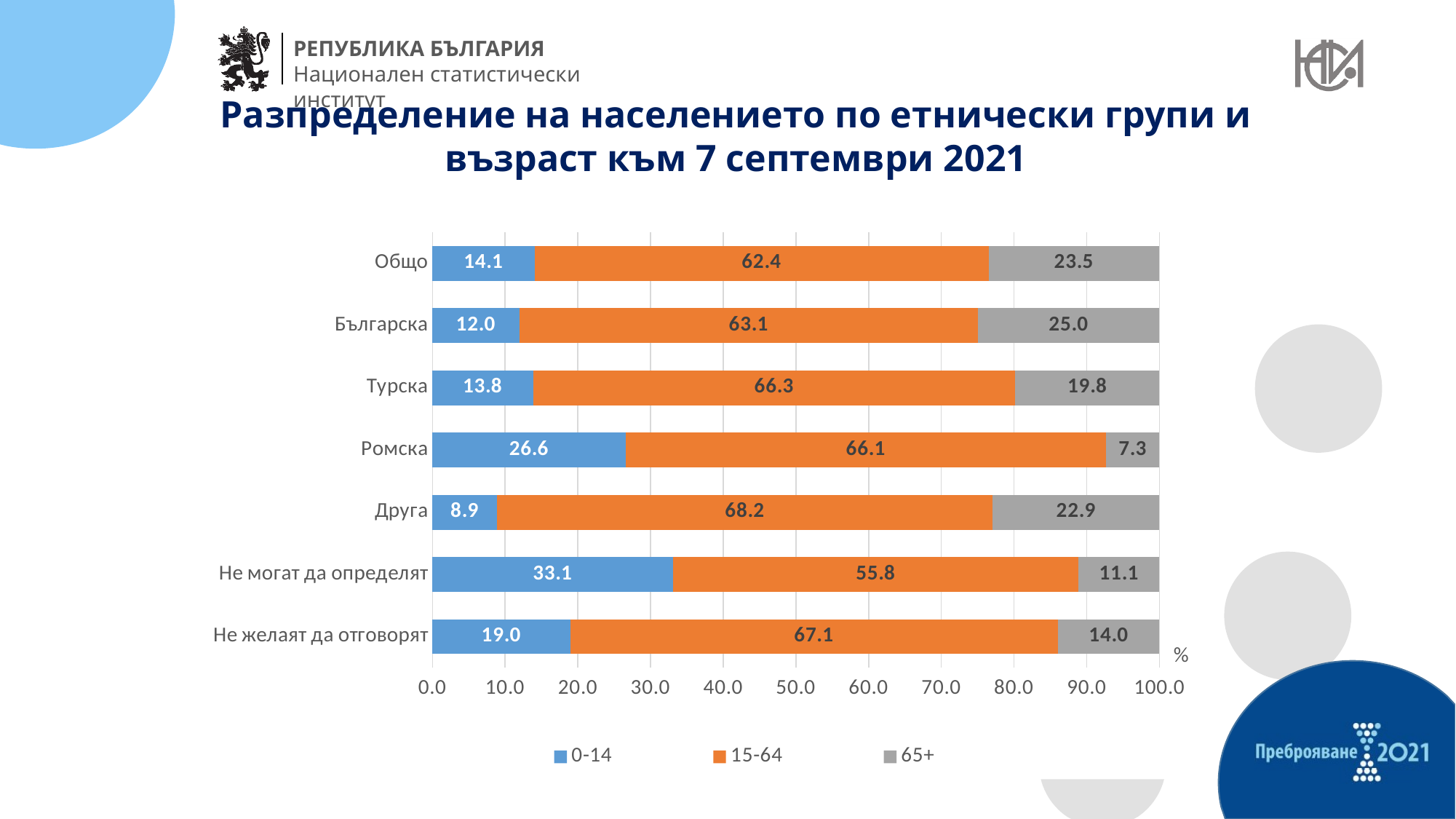
How many categories are shown on the y axis of the chart? 7 What is the difference between the 65+ values for Българска and Ромска? 17.7 Which is larger: the 15-64 value for Турска or the 15-64 value for Общо? Турска What is the value of the 65+ series for Българска? 25.0 What is the value of the 15-64 series for Не желаят да отговорят? 67.1 What kind of chart is shown on the slide? Stacked bar chart What is the value of the 0-14 series for Ромска? 26.6 What is the total of the stacked bar for Не могат да определят? 100.0 Which category has the lowest value in the 0-14 series? Друга Which category has the highest value in the 0-14 series? Не могат да определят How many series does the legend list? 3 Which category has the lowest value in the 65+ series? Ромска